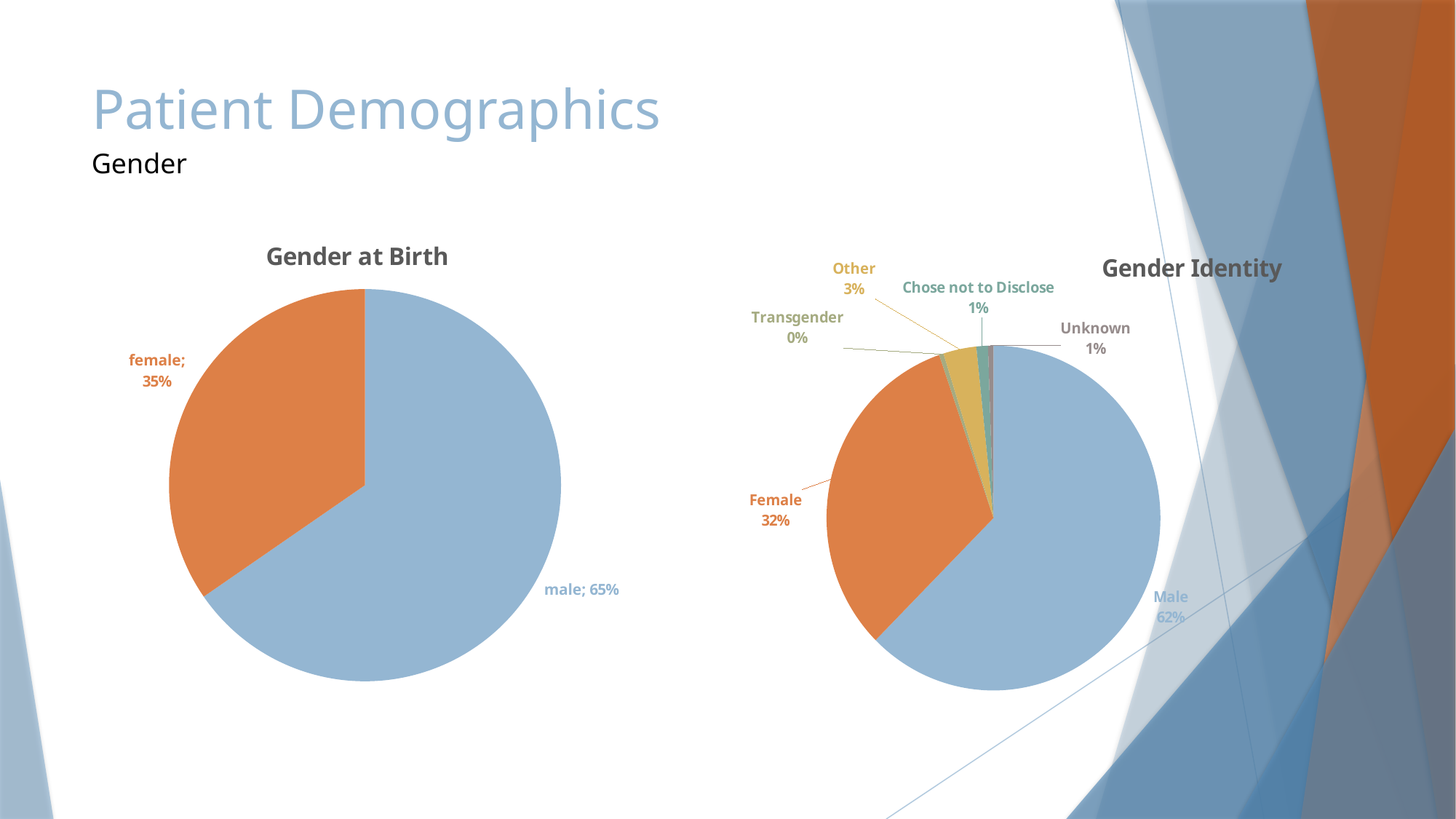
In the Gender at Birth chart, what percentage is labelled for female? 35% In the Gender Identity chart, which is larger, the share for Other or the share for Unknown? Other In the Gender Identity chart, what percentage is shown for Transgender? 0% In the Gender at Birth chart, what is the difference in percentage points between male and female? 30 In the Gender at Birth chart, what percentage is labelled for male? 65% In the Gender Identity chart, which category has the smallest share? Transgender What type of chart is the Gender at Birth chart? Pie chart In the Gender Identity chart, which category has the largest share? Male In the Gender Identity chart, what percentage is shown for Other? 3% In the Gender Identity chart, what percentage is shown for Female? 32% How many categories does the Gender Identity chart show? 6 In the Gender Identity chart, what is the difference in percentage points between Male and Female? 30